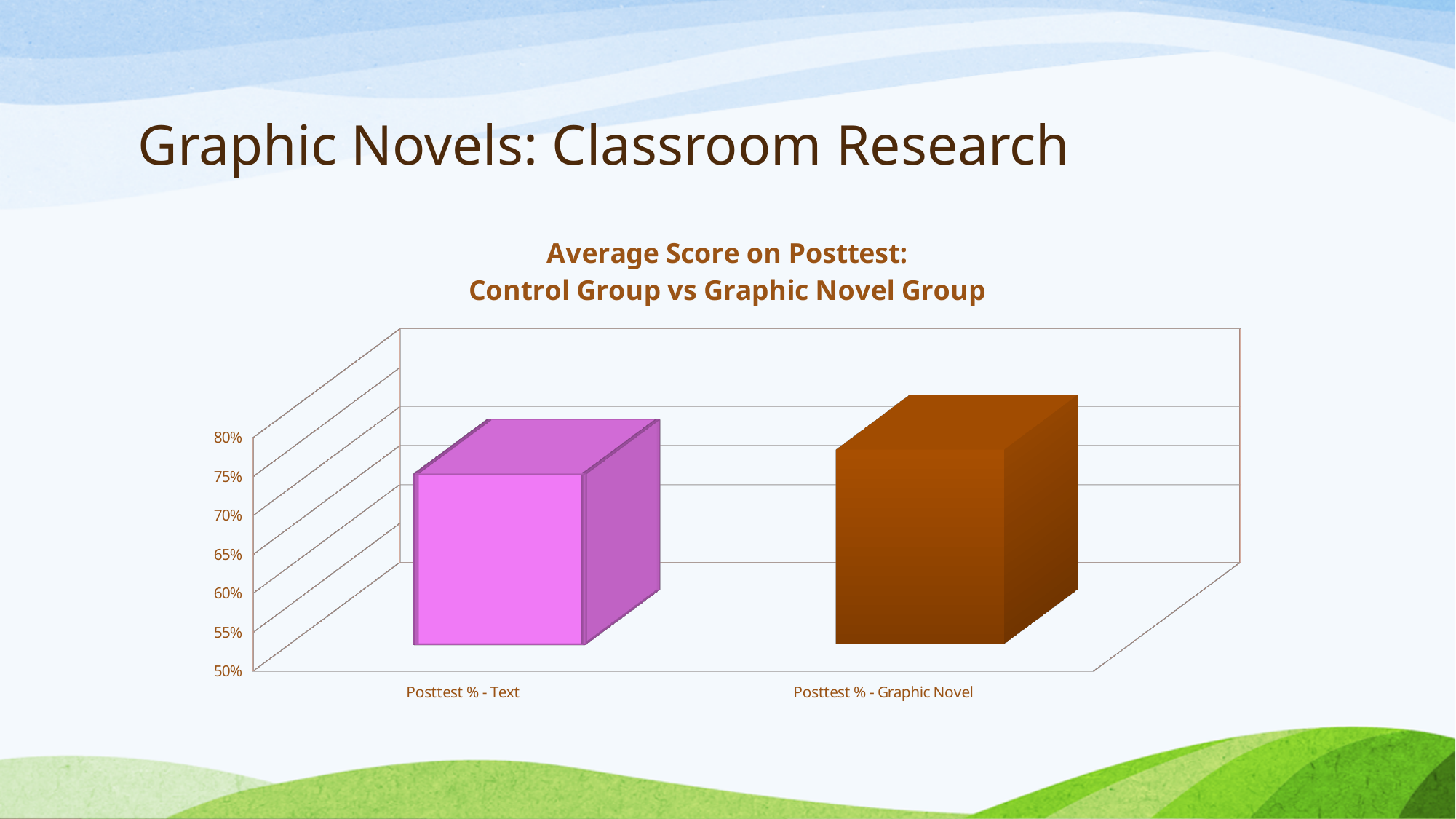
Is the value for Posttest % - Graphic Novel greater or less than 65%? greater Which is larger, the value for Posttest % - Text or Posttest % - Graphic Novel? Posttest % - Graphic Novel Is the value for Posttest % - Text greater or less than 80%? less Which category has the lowest average posttest score? Posttest % - Text What colour is the bar for Posttest % - Graphic Novel? brown What is the lowest value shown on the vertical axis? 50% Is the value for Posttest % - Graphic Novel greater or less than 80%? less How many bars are plotted in the chart? 2 Which category has the highest average posttest score? Posttest % - Graphic Novel What kind of chart is shown on the slide? bar chart What is the title of the chart? Average Score on Posttest: Control Group vs Graphic Novel Group